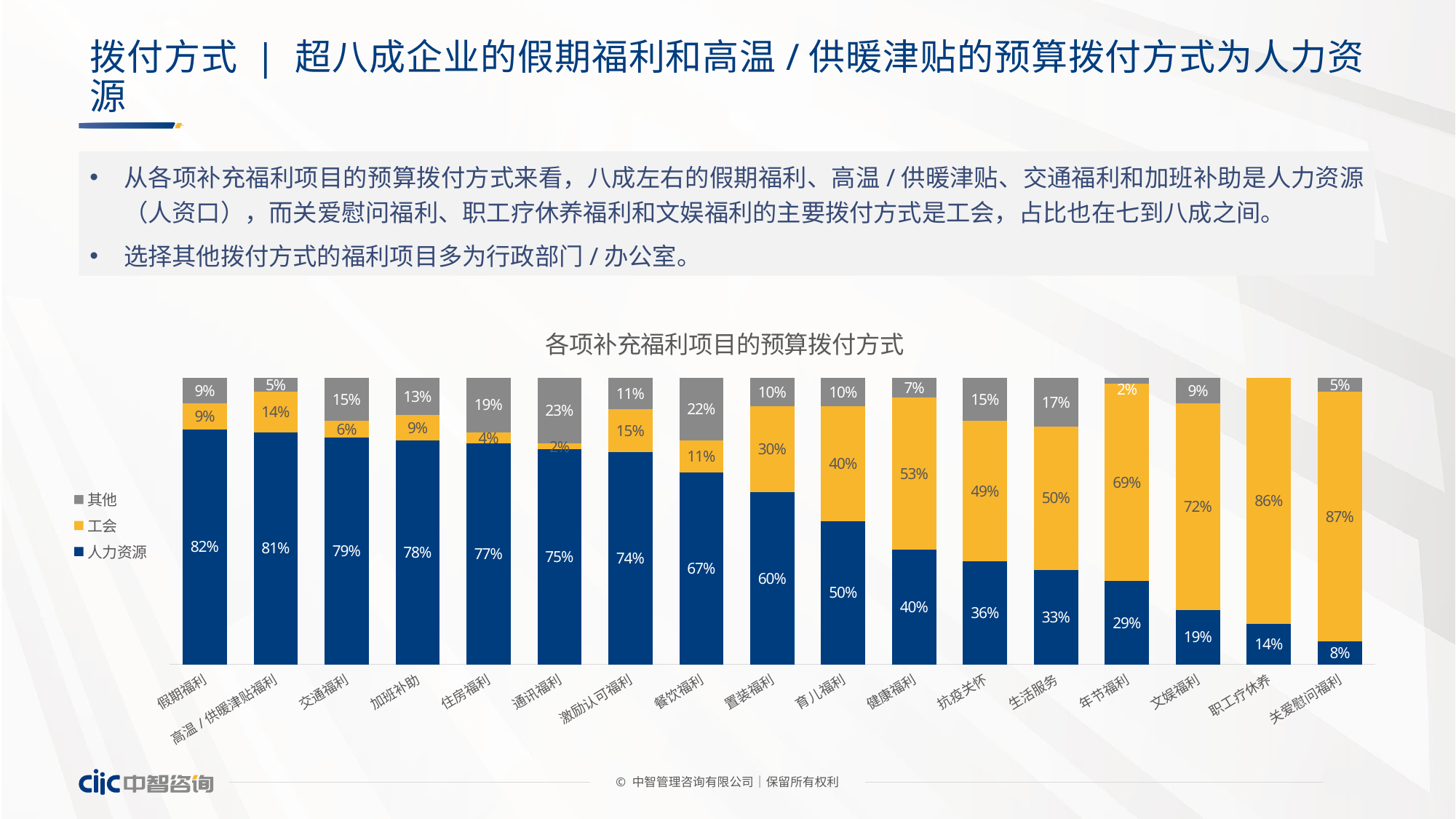
What is the 其他 share for 通讯福利? 23% What is the difference between the 人力资源 share for 假期福利 and for 关爱慰问福利? 74 percentage points What is the 工会 share for 职工疗休养? 86% Which category has the highest 工会 share? 关爱慰问福利 Which is larger: the 工会 share for 健康福利 or for 抗疫关怀? 健康福利 How many benefit categories are shown on the x axis? 17 What kind of chart is shown on the slide? Stacked bar chart How many series does the legend list? 3 What is the 人力资源 share for 假期福利? 82% Which category has the lowest 人力资源 share? 关爱慰问福利 Which category has the highest 人力资源 share? 假期福利 Does the 人力资源 share rise or fall moving from left to right along the x axis? Fall